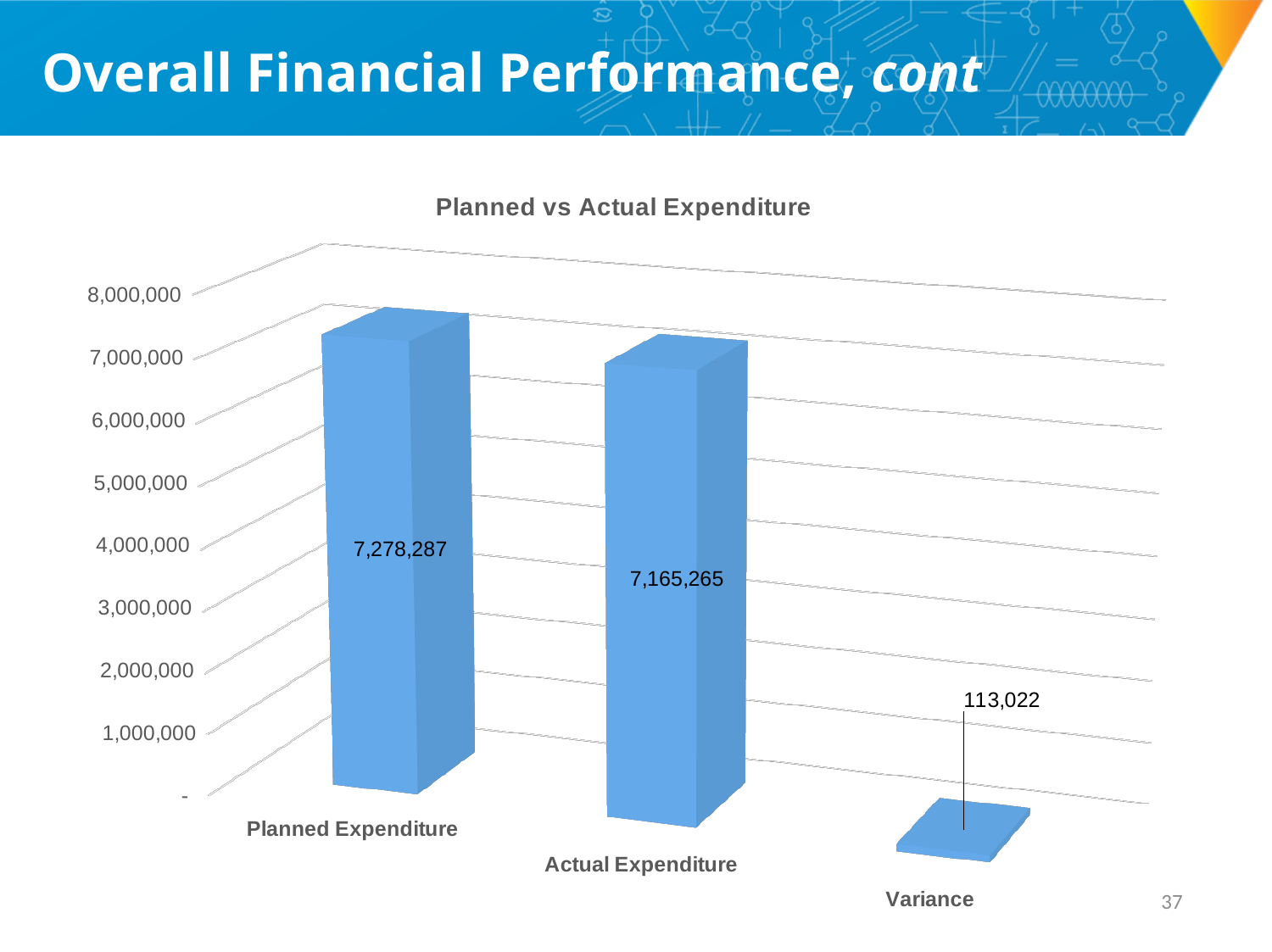
How many categories are shown in the chart? 3 Which category has the lowest value? Variance Which is larger, Planned Expenditure or Actual Expenditure? Planned Expenditure Is the value for Actual Expenditure greater or less than 7,000,000? greater Which category has the highest value? Planned Expenditure What is the difference between Planned Expenditure and Actual Expenditure? 113,022 Is the value for Variance greater or less than 1,000,000? less What is the title of the chart? Planned vs Actual Expenditure What is the value for Actual Expenditure? 7,165,265 What is the value for Variance? 113,022 What is the value for Planned Expenditure? 7,278,287 What kind of chart is shown on the slide? bar chart